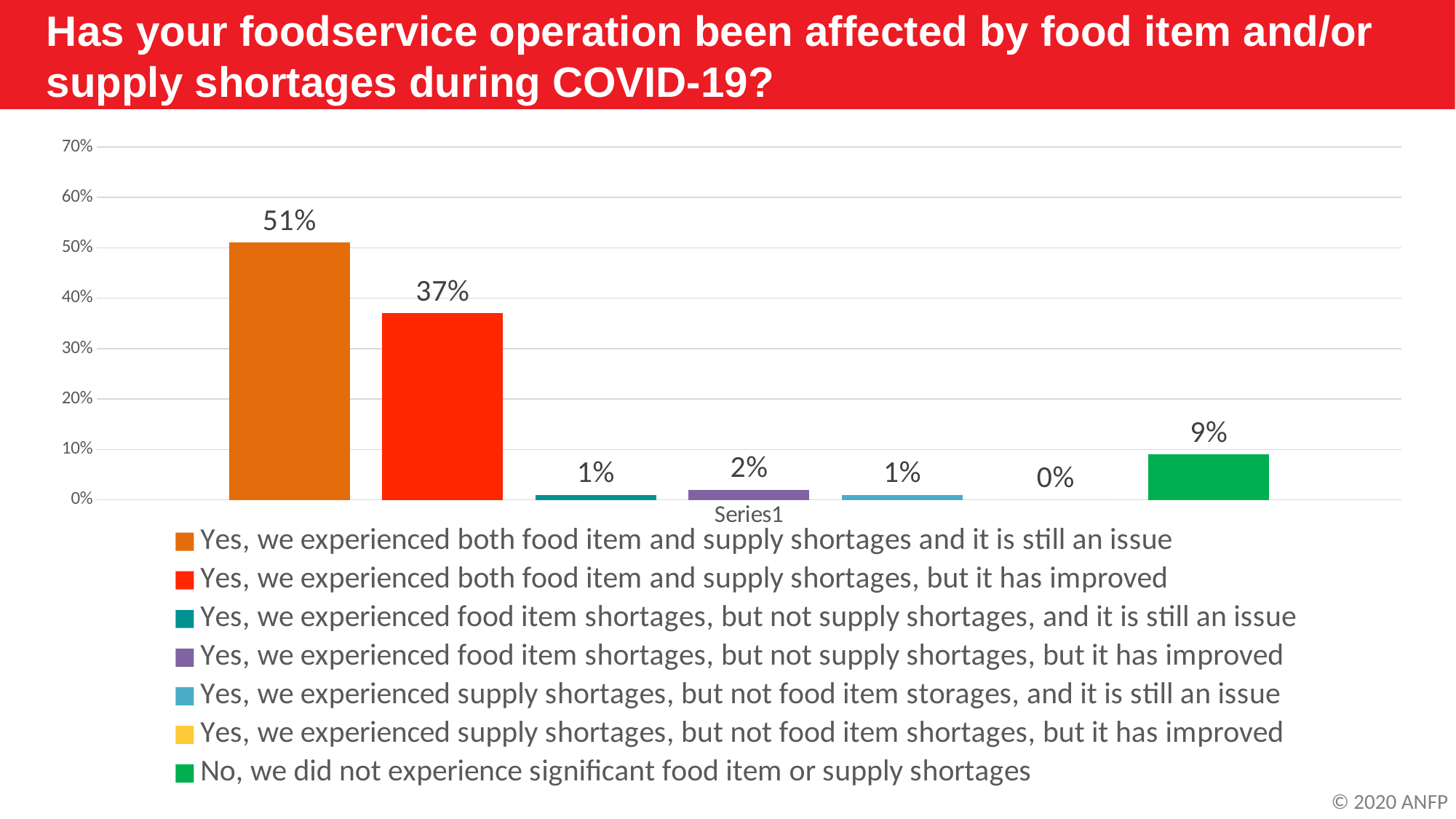
What percentage of respondents said they experienced both food item and supply shortages and it is still an issue? 51% How many entries does the legend list? 7 What percentage of respondents said they experienced food item shortages, but not supply shortages, but it has improved? 2% How many bars are plotted on the chart? 7 What is the difference in percentage points between the 'still an issue' and 'has improved' responses for both food item and supply shortages? 14 What type of chart is shown on the slide? Bar chart Which is larger: the percentage for 'No, we did not experience significant food item or supply shortages' or for 'Yes, we experienced food item shortages, but not supply shortages, but it has improved'? No, we did not experience significant food item or supply shortages What percentage of respondents said they experienced both food item and supply shortages, but it has improved? 37% What percentage of respondents said they experienced supply shortages, but not food item shortages, but it has improved? 0% Which response has the lowest percentage? Yes, we experienced supply shortages, but not food item shortages, but it has improved What percentage of respondents said they did not experience significant food item or supply shortages? 9% Which response has the highest percentage? Yes, we experienced both food item and supply shortages and it is still an issue